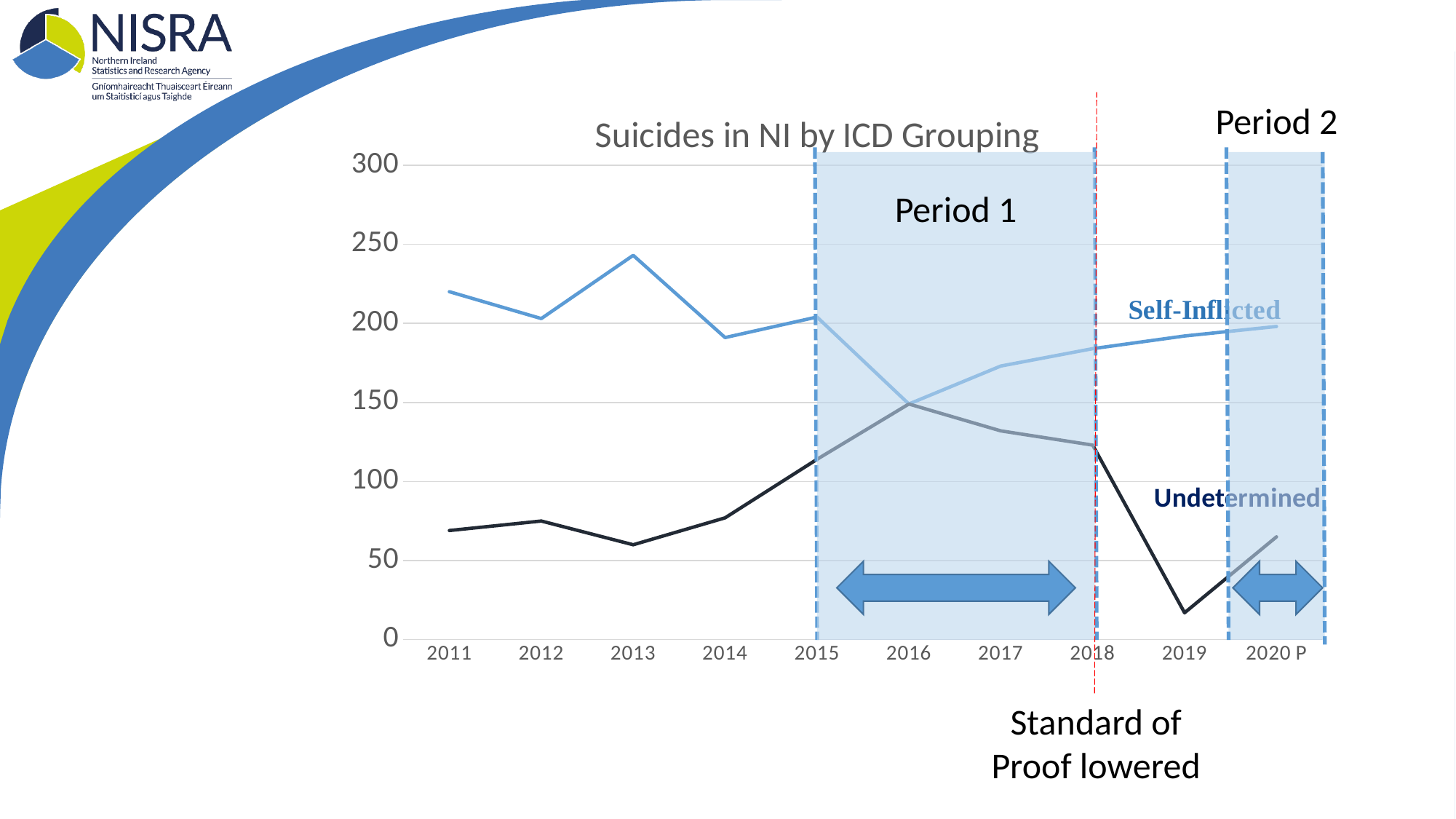
What is the title of the chart? Suicides in NI by ICD Grouping What kind of chart is shown on the slide? line chart Is the Undetermined value for 2018 greater or less than 100? greater In which year does the Undetermined series reach its highest value? 2016 In 2011, which series has the larger value, Self-Inflicted or Undetermined? Self-Inflicted Does the Undetermined series rise or fall between 2013 and 2016? rise Is the Self-Inflicted value for 2013 greater or less than 200? greater How many years are shown along the x axis of the chart? 10 Is the Undetermined value for 2019 greater or less than 50? less In which year does the Self-Inflicted series reach its highest value? 2013 In which year does the Undetermined series reach its lowest value? 2019 How many series are plotted on the chart? 2